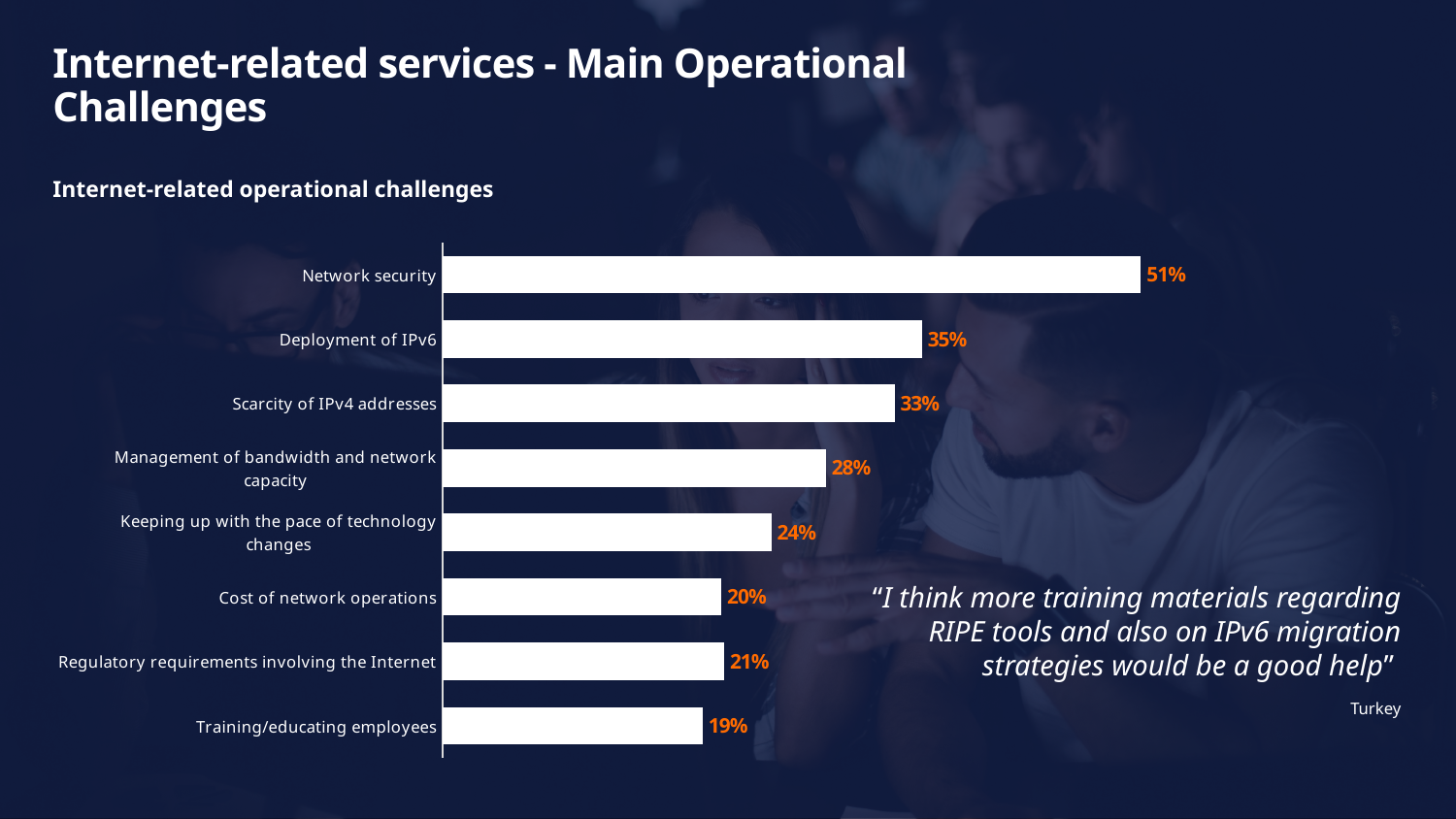
What kind of chart is shown on the slide? Bar chart What is the title of the chart? Internet-related operational challenges How many operational challenges are shown in the chart? 8 What is the difference between the values for Scarcity of IPv4 addresses and Keeping up with the pace of technology changes? 9% What is the value for Deployment of IPv6? 35% Which operational challenge has the highest percentage? Network security Which operational challenge has the lowest percentage? Training/educating employees Which is larger: the value for Cost of network operations or the value for Regulatory requirements involving the Internet? Regulatory requirements involving the Internet What is the difference between the values for Network security and Deployment of IPv6? 16% What percentage of respondents cited Network security as an operational challenge? 51% What is the value for Management of bandwidth and network capacity? 28% What is the value for Regulatory requirements involving the Internet? 21%